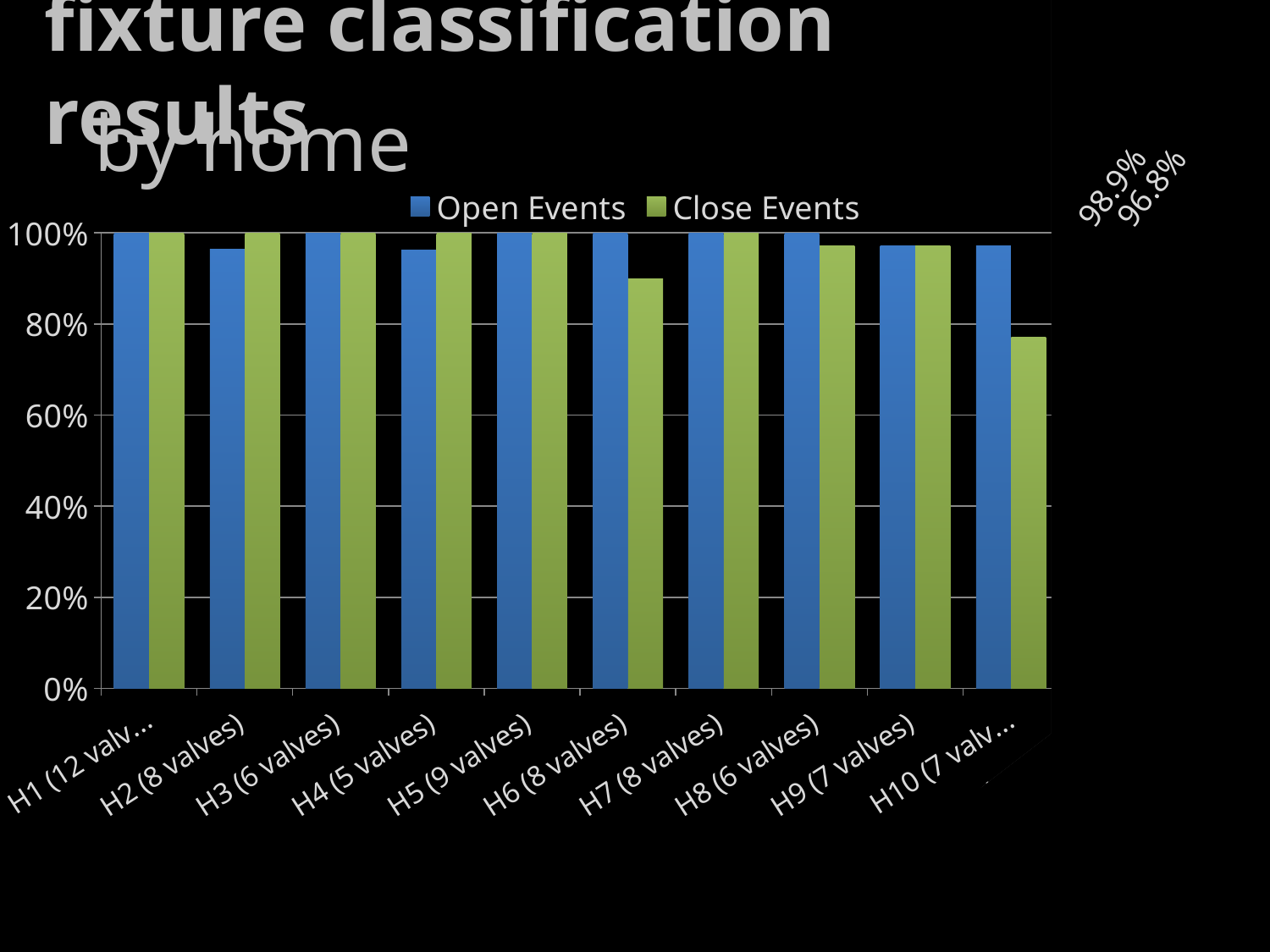
What are the two series named in the legend? Open Events and Close Events Is the Close Events value for H10 greater or less than 80%? less Which home has the lowest Close Events value? H10 (7 valves) Which series is shown in green? Close Events For H6 (8 valves), which is larger: Open Events or Close Events? Open Events For H10, which is larger: Open Events or Close Events? Open Events What kind of chart is shown on the slide? bar chart Is the Close Events value for H6 (8 valves) greater or less than 80%? greater What is the Open Events value for H1 (12 valves)? 100% How many homes (categories) are shown on the x axis? 10 Is the Open Events value for H2 (8 valves) greater or less than 80%? greater How many series does the legend list? 2